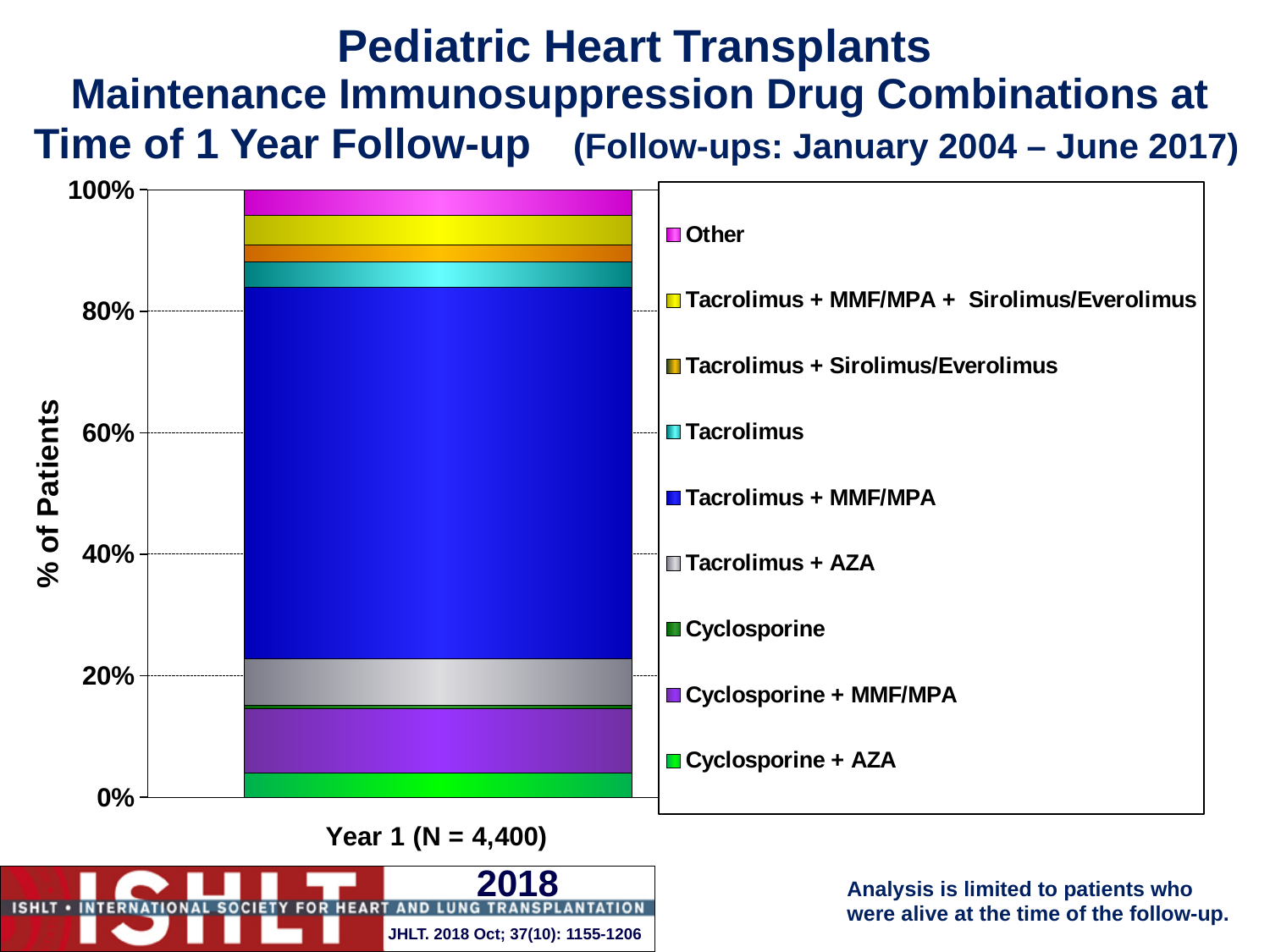
What kind of chart is shown on the slide? Stacked bar chart Is the share for Tacrolimus + MMF/MPA greater or less than 40%? greater How many bars (categories) are plotted on the x axis? 1 Which is larger, the segment for Cyclosporine + AZA or the segment for Cyclosporine? Cyclosporine + AZA What is the label of the single bar on the x axis? Year 1 (N = 4,400) Is the share for Cyclosporine + AZA greater or less than 20%? less Which is larger, the segment for Tacrolimus + MMF/MPA or the segment for Other? Tacrolimus + MMF/MPA How many series does the legend list? 9 Which drug combination makes up the largest segment of the stacked bar? Tacrolimus + MMF/MPA Which drug combination makes up the smallest segment of the stacked bar? Cyclosporine What is the y-axis label of the chart? % of Patients